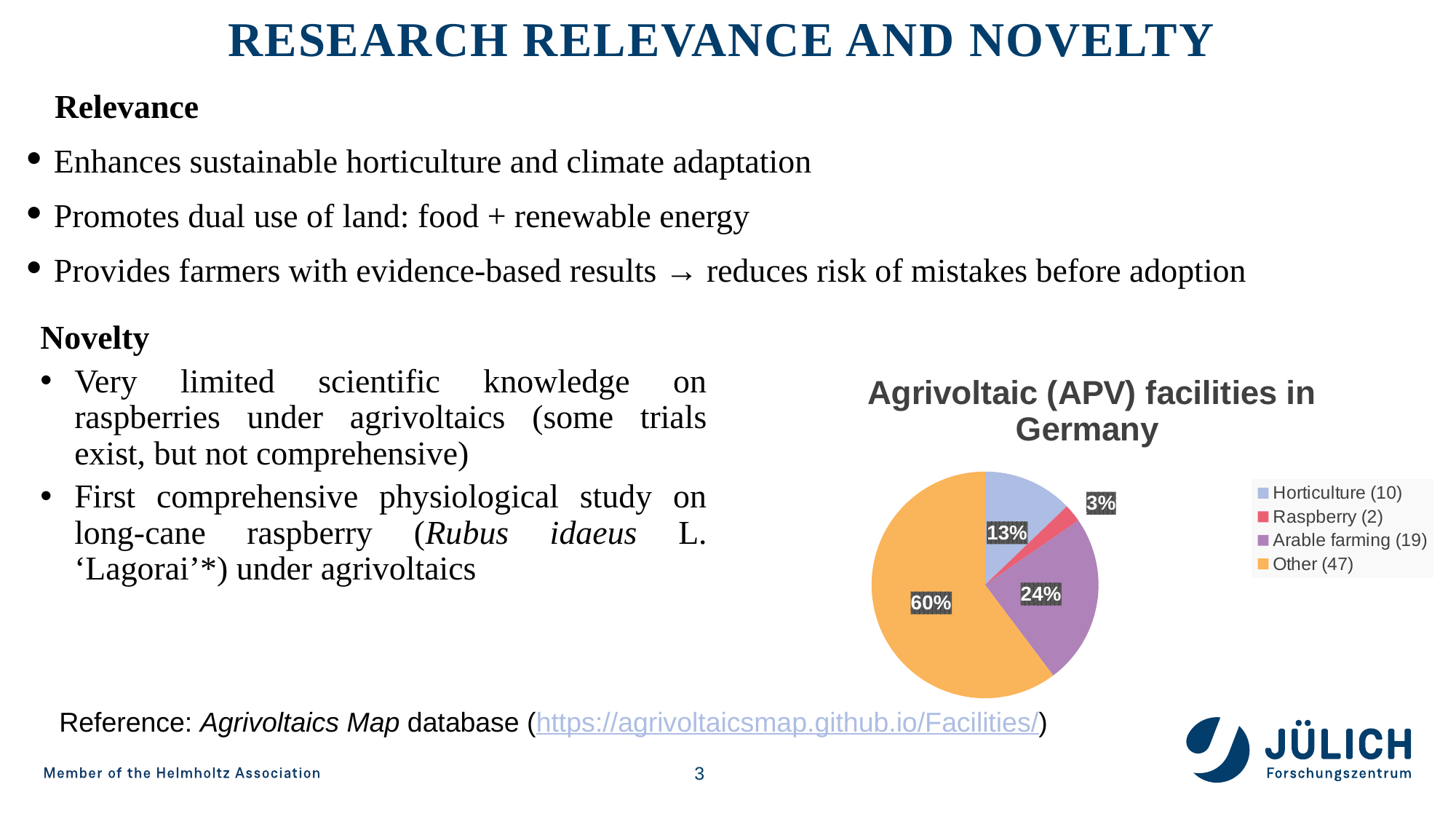
What percentage share does the Raspberry slice have? 3% What kind of chart is shown on the slide? pie chart What is the difference in percentage points between the Other slice and the Arable farming slice? 36% What is the title of the chart? Agrivoltaic (APV) facilities in Germany Which category has the largest slice of the pie? Other How many categories does the pie chart show? 4 What percentage share does the Horticulture slice have? 13% What percentage share does the Other slice have in the pie chart? 60% How many facilities are listed for Arable farming in the legend? 19 Which category has the smallest slice of the pie? Raspberry Which slice is larger, Horticulture or Arable farming? Arable farming